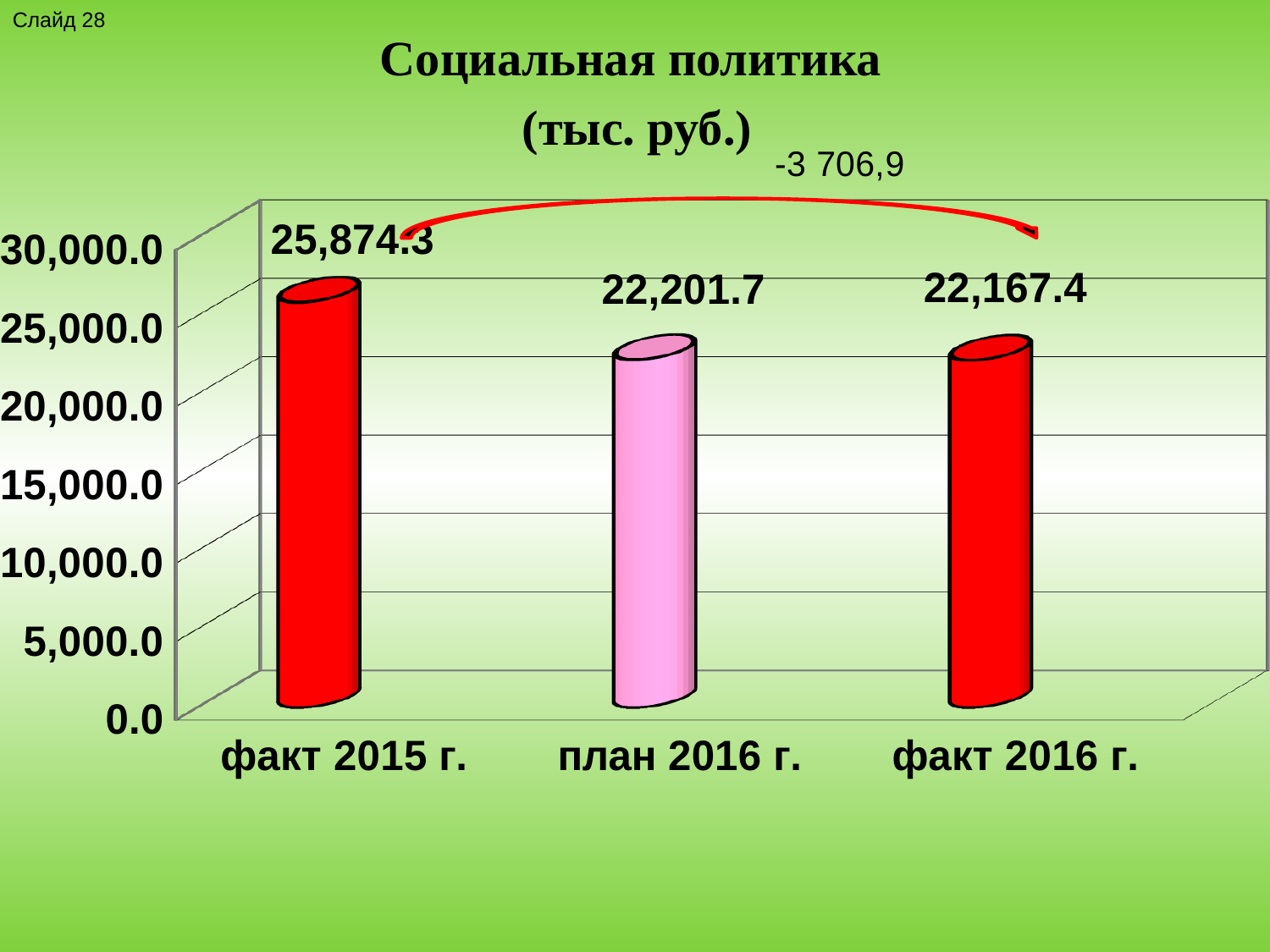
Which is larger, the value for факт 2015 г. or the value for план 2016 г.? факт 2015 г. What kind of chart is shown on the slide? bar chart How many categories are shown on the x axis? 3 Is the value for план 2016 г. greater or less than 25,000.0? less What is the value for факт 2015 г.? 25,874.3 What is the difference between the values for план 2016 г. and факт 2016 г.? 34.3 What is the title of the chart? Социальная политика (тыс. руб.) What is the difference between the values for факт 2015 г. and факт 2016 г.? 3,706.9 Which category has the highest value? факт 2015 г. What is the value for факт 2016 г.? 22,167.4 Which category has the lowest value? факт 2016 г. What is the value for план 2016 г.? 22,201.7